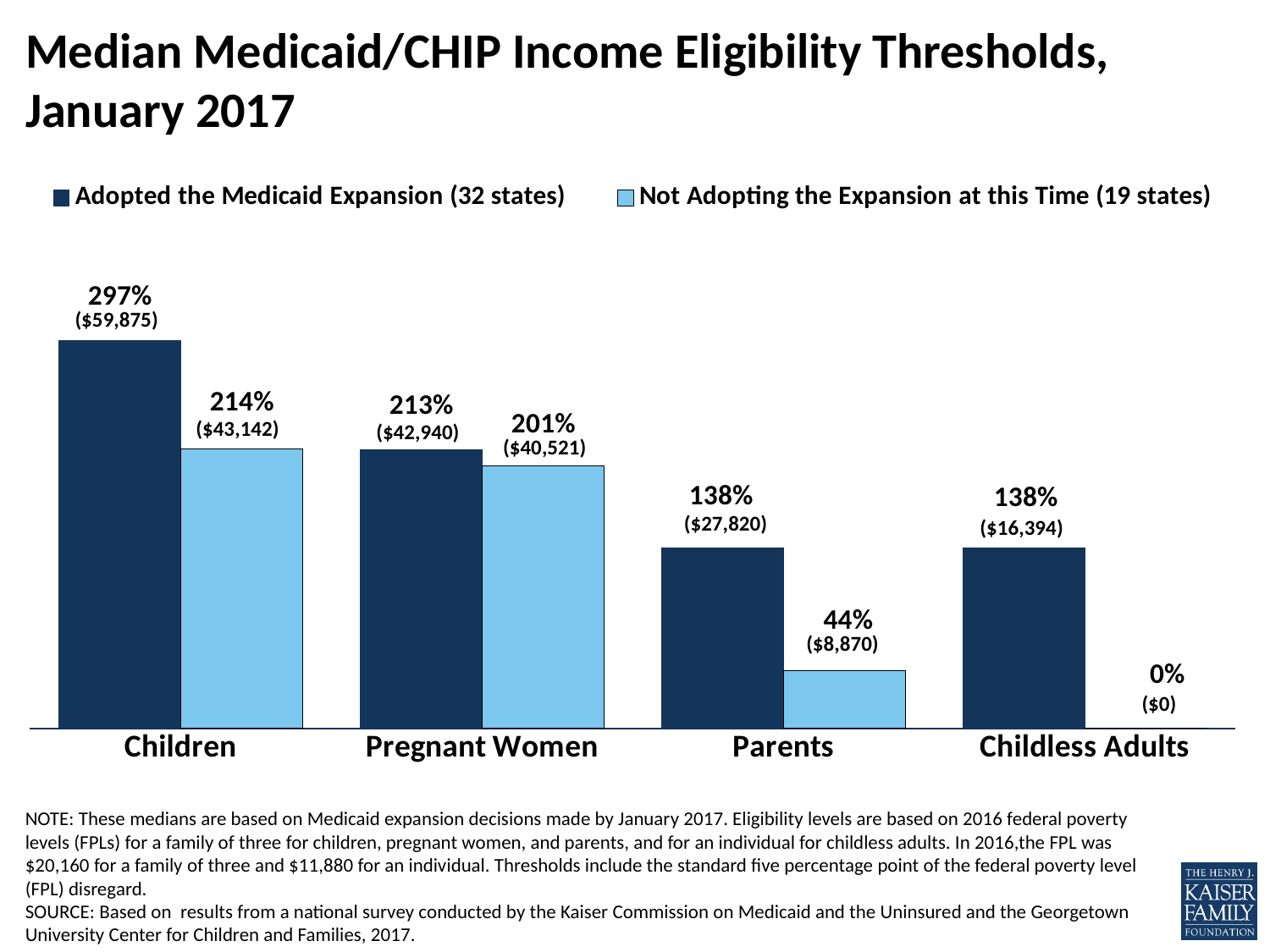
Which category has the lowest threshold among states not adopting the expansion? Childless Adults Do the thresholds for states that adopted the Medicaid expansion rise or fall from Children to Parents? Fall How many states are in the 'Not Adopting the Expansion at this Time' group according to the legend? 19 states What is the median income eligibility threshold for Children in states that adopted the Medicaid expansion? 297% How many series does the legend list? 2 What is the difference in percentage points between the Children thresholds for expansion states and non-expansion states? 83 percentage points What dollar amount is shown for Pregnant Women in states not adopting the expansion? $40,521 How many categories are shown on the x axis? 4 What is the median income eligibility threshold for Parents in states not adopting the expansion at this time? 44% For Parents, which group has the higher threshold: states that adopted the expansion or states not adopting it? Adopted the Medicaid Expansion What kind of chart is shown on the slide? Bar chart Which category has the highest threshold among states that adopted the Medicaid expansion? Children